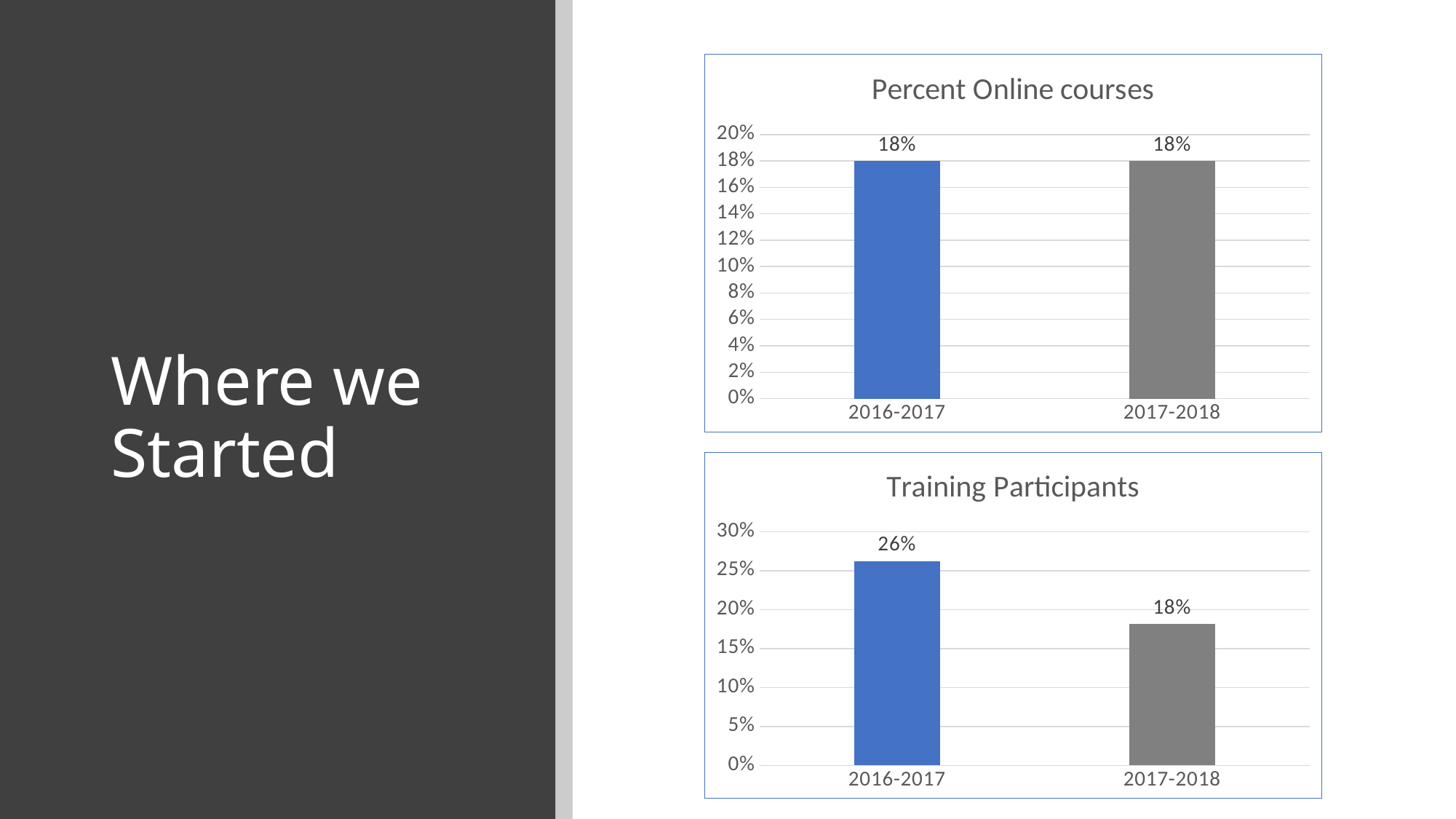
In the 'Training Participants' chart, do the values rise or fall from 2016-2017 to 2017-2018? fall In the 'Percent Online courses' chart, what is the value for 2017-2018? 18% In the 'Training Participants' chart, what is the value for 2016-2017? 26% How many categories are shown in the 'Percent Online courses' chart? 2 In the 'Training Participants' chart, which year has the highest value? 2016-2017 In the 'Training Participants' chart, is the value for 2016-2017 greater or less than 25%? greater In the 'Percent Online courses' chart, what is the value for 2016-2017? 18% What kind of chart is the 'Training Participants' chart? bar chart In the 'Training Participants' chart, what is the value for 2017-2018? 18% What is the title of the top chart on the slide? Percent Online courses In the 'Training Participants' chart, which year has the lowest value? 2017-2018 In the 'Training Participants' chart, what is the difference between the 2016-2017 and 2017-2018 values? 8%